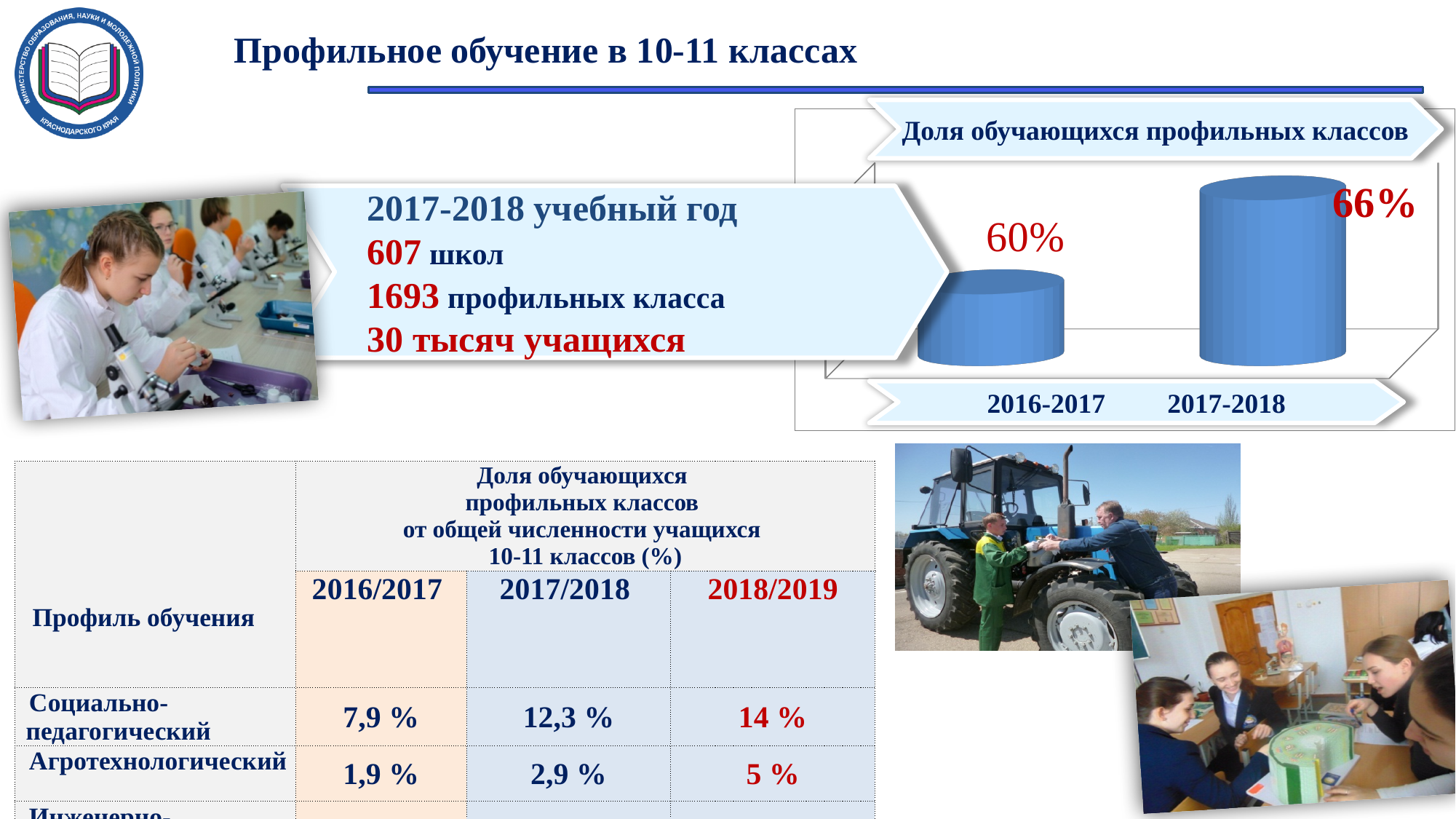
How many categories are plotted in the chart "Доля обучающихся профильных классов"? 2 What colour are the bars in the chart "Доля обучающихся профильных классов"? blue In the chart "Доля обучающихся профильных классов", what is the value for 2016-2017? 60% In the chart "Доля обучающихся профильных классов", do the values rise or fall from 2016-2017 to 2017-2018? rise What kind of chart is shown under the title "Доля обучающихся профильных классов"? bar chart In the chart "Доля обучающихся профильных классов", which is larger: the value for 2016-2017 or for 2017-2018? 2017-2018 In the chart "Доля обучающихся профильных классов", which year has the highest value? 2017-2018 In the chart "Доля обучающихся профильных классов", by how many percentage points does 2017-2018 exceed 2016-2017? 6 In the chart "Доля обучающихся профильных классов", which year has the lowest value? 2016-2017 In the chart "Доля обучающихся профильных классов", what is the value for 2017-2018? 66% What is the title of the chart on the slide? Доля обучающихся профильных классов